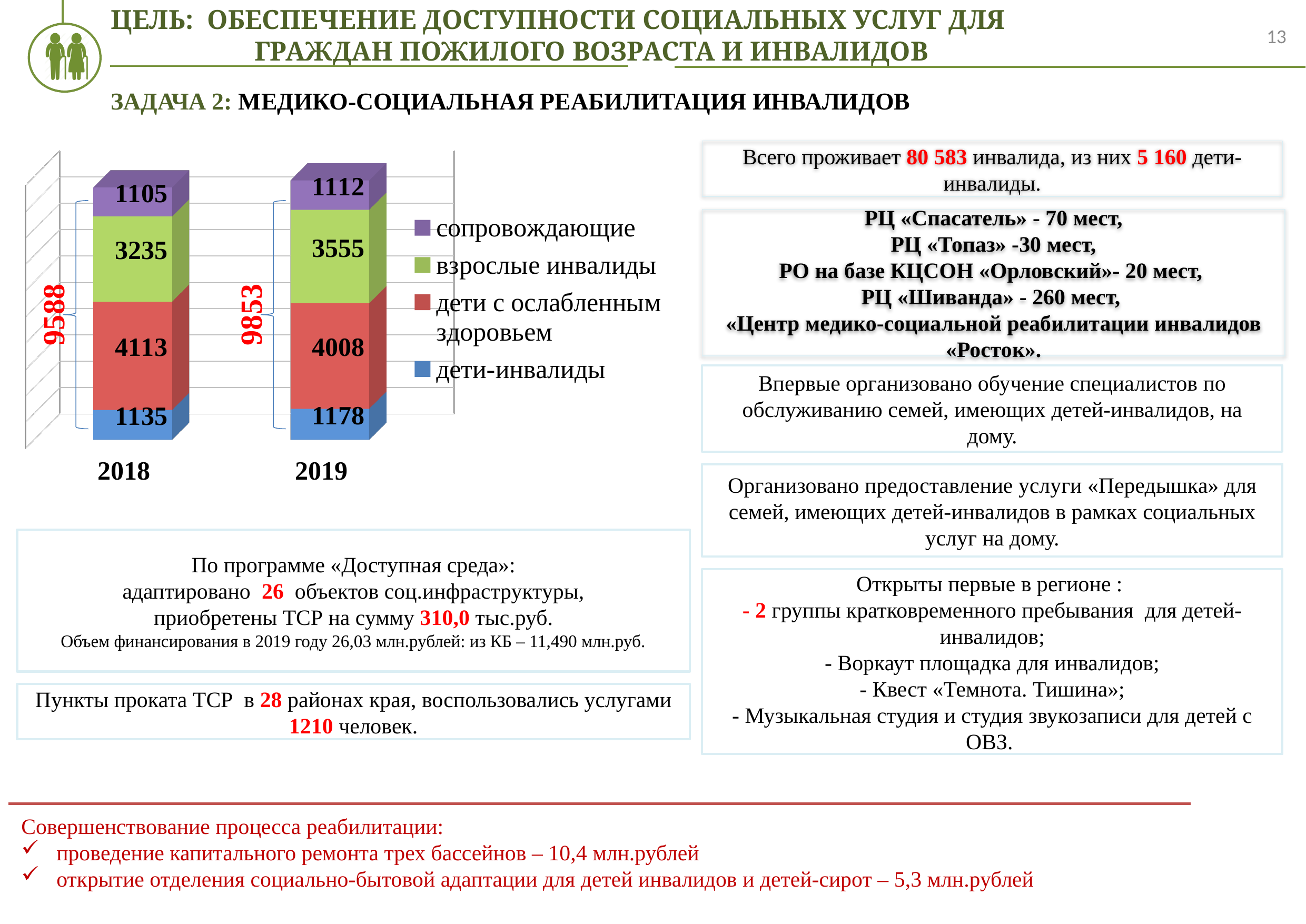
Which series has the smallest value in the 2018 bar? сопровождающие What is the value for «взрослые инвалиды» in 2019? 3555 What type of chart is shown on the slide? stacked bar chart Which is larger: «дети с ослабленным здоровьем» in 2018 or in 2019? 2018 What is the difference between the «взрослые инвалиды» values for 2019 and 2018? 320 How many categories (years) are shown on the x axis of the chart? 2 What is the value for «сопровождающие» in 2019? 1112 Which series has the largest value in the 2019 bar? дети с ослабленным здоровьем What is the value for «дети-инвалиды» in 2018? 1135 What is the value for «дети с ослабленным здоровьем» in 2018? 4113 How many series does the chart legend list? 4 What is the total of the stacked bar for 2019? 9853